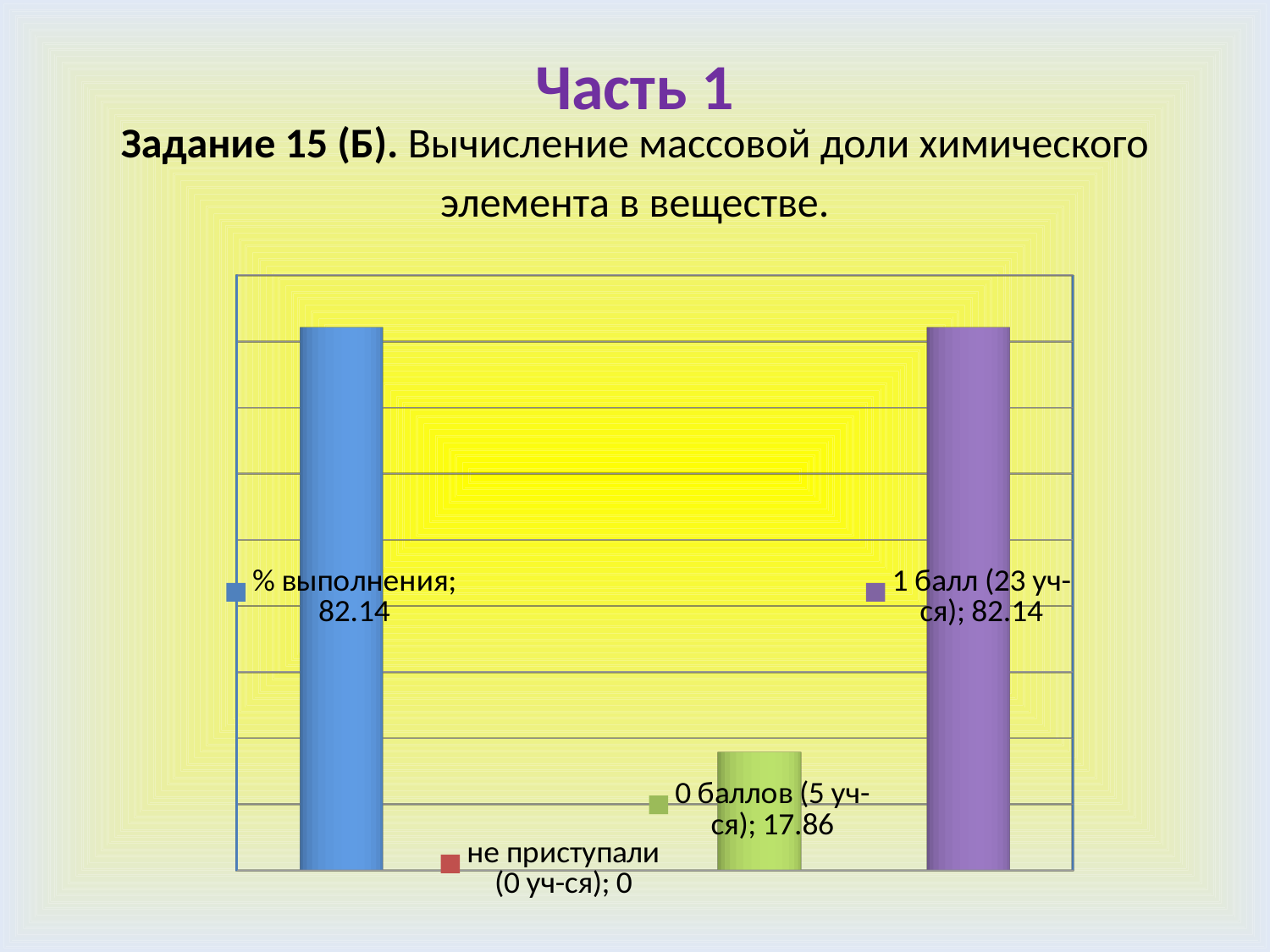
What is the value shown for "0 баллов (5 уч-ся)"? 17.86 What is the value shown for "% выполнения"? 82.14 What colour is the bar for "1 балл (23 уч-ся)"? purple Which is larger, the value for "0 баллов (5 уч-ся)" or the value for "1 балл (23 уч-ся)"? 1 балл (23 уч-ся) What is the value shown for "1 балл (23 уч-ся)"? 82.14 What is the value shown for "не приступали (0 уч-ся)"? 0 How many students scored 1 балл according to the chart label? 23 What is the difference between the values for "1 балл (23 уч-ся)" and "0 баллов (5 уч-ся)"? 64.28 Which task number is named in the slide title above the chart? Задание 15 (Б) Which category has the lowest value? не приступали (0 уч-ся) What kind of chart is shown on the slide? bar chart How many categories are plotted in the chart? 4